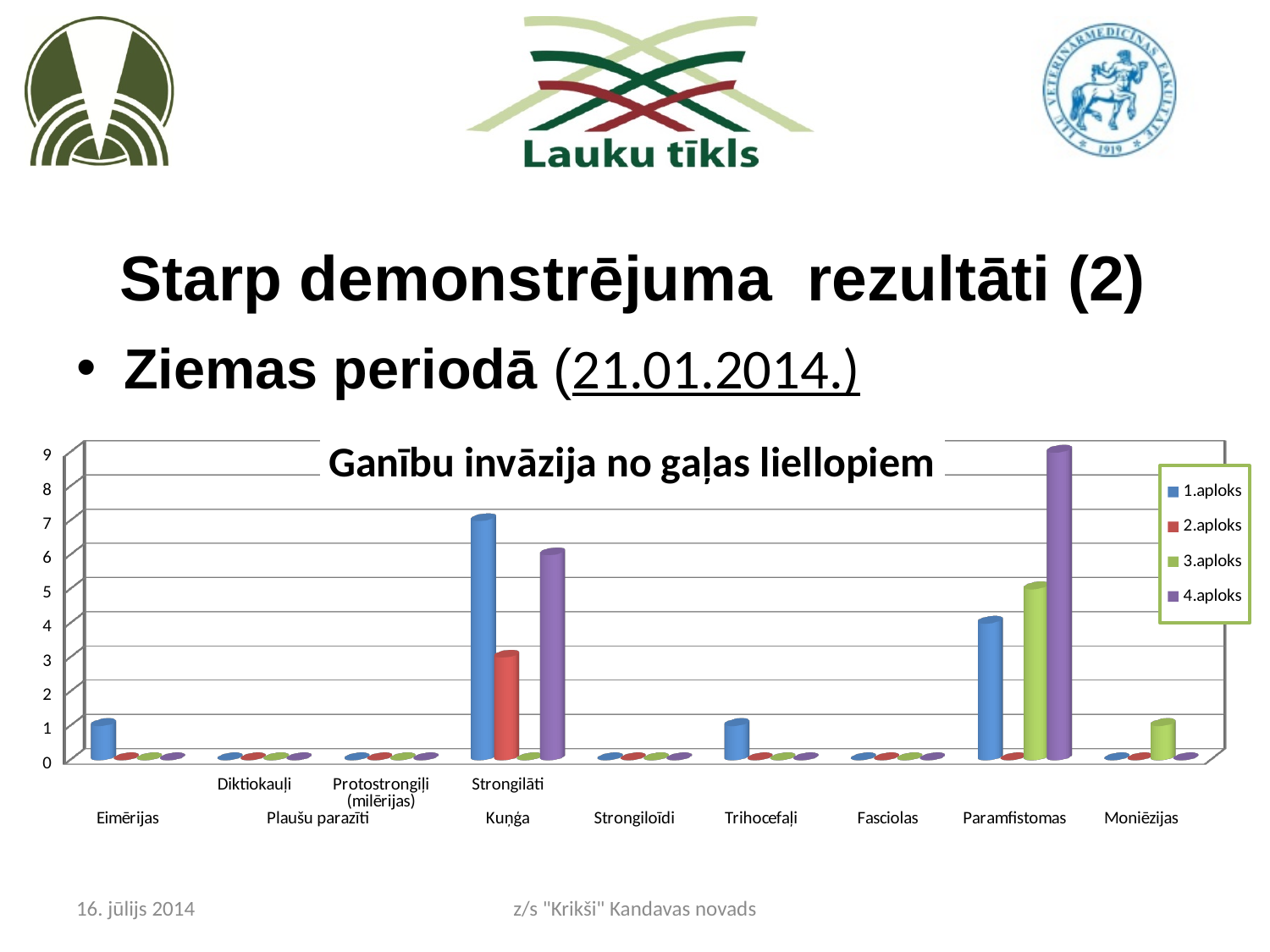
What kind of chart is shown on the slide? bar chart Which is larger at Paramfistomas: the value for 1.aploks or the value for 4.aploks? 4.aploks Is the value for 4.aploks at Paramfistomas greater or less than 8? greater How many series does the chart legend list? 4 Is the value for 2.aploks at Strongilāti greater or less than 5? less What is the title of the chart? Ganību invāzija no gaļas liellopiem Which is larger at Strongilāti: the value for 2.aploks or the value for 4.aploks? 4.aploks Which series has a non-zero bar at Moniēzijas? 3.aploks Which series has the tallest bar in the whole chart? 4.aploks For which category does the 4.aploks series reach its highest value? Paramfistomas For which category does the 1.aploks series reach its highest value? Strongilāti Is the value for 1.aploks at Strongilāti greater or less than 5? greater